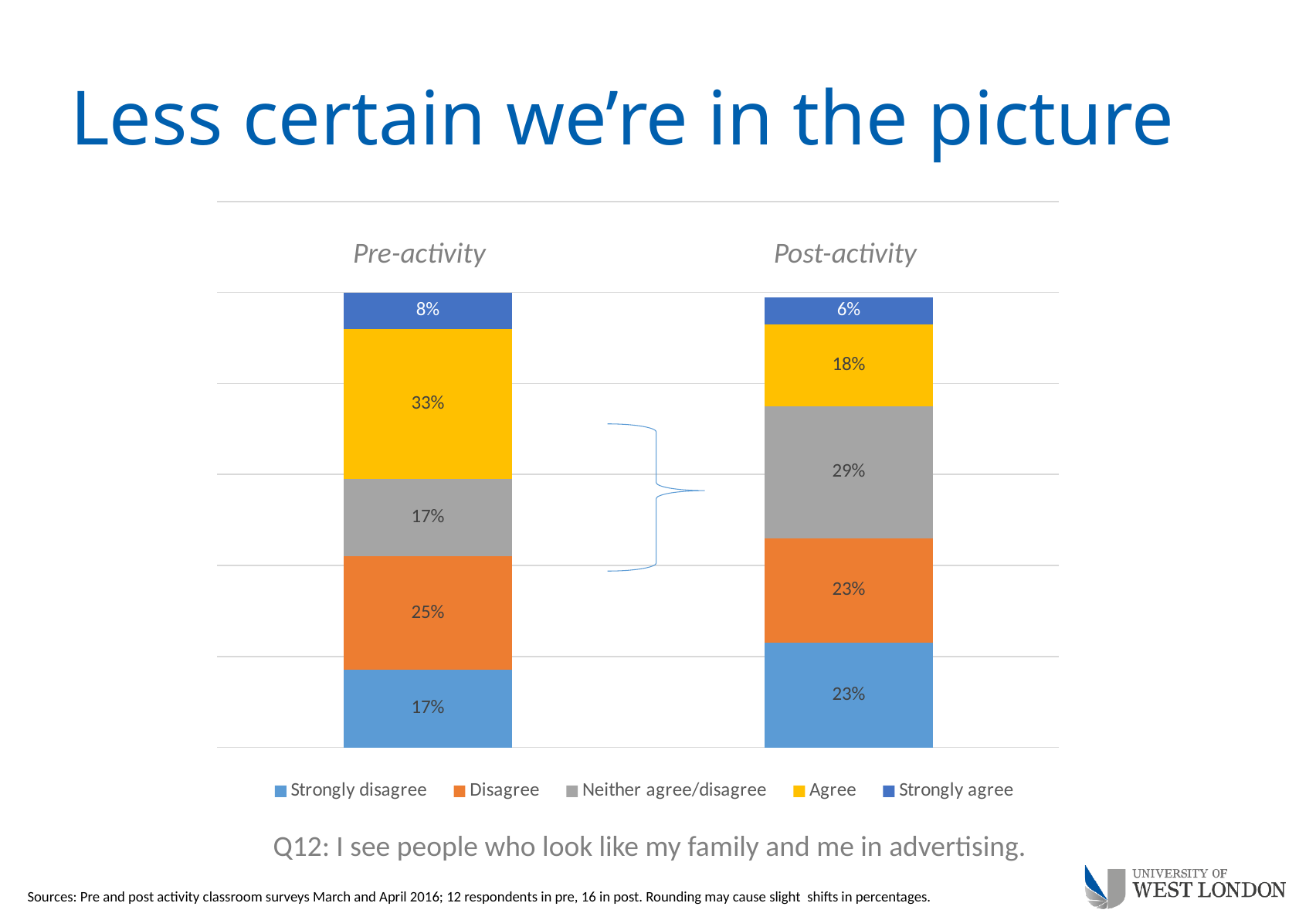
What is the Agree value for the Pre-activity bar? 33% What is the Disagree value for the Pre-activity bar? 25% How many bars are plotted in the chart? 2 By how many percentage points did the Agree share fall from Pre-activity to Post-activity? 15 Which response category has the smallest share in the Post-activity bar? Strongly agree Which response category has the largest share in the Pre-activity bar? Agree Is the Neither agree/disagree share larger in the Pre-activity bar or the Post-activity bar? Post-activity How many series does the legend list? 5 Which survey question does the chart relate to, according to the caption below the chart? Q12: I see people who look like my family and me in advertising. What kind of chart is shown on the slide? Stacked bar chart What is the Strongly agree value for the Post-activity bar? 6% What is the Neither agree/disagree value for the Post-activity bar? 29%